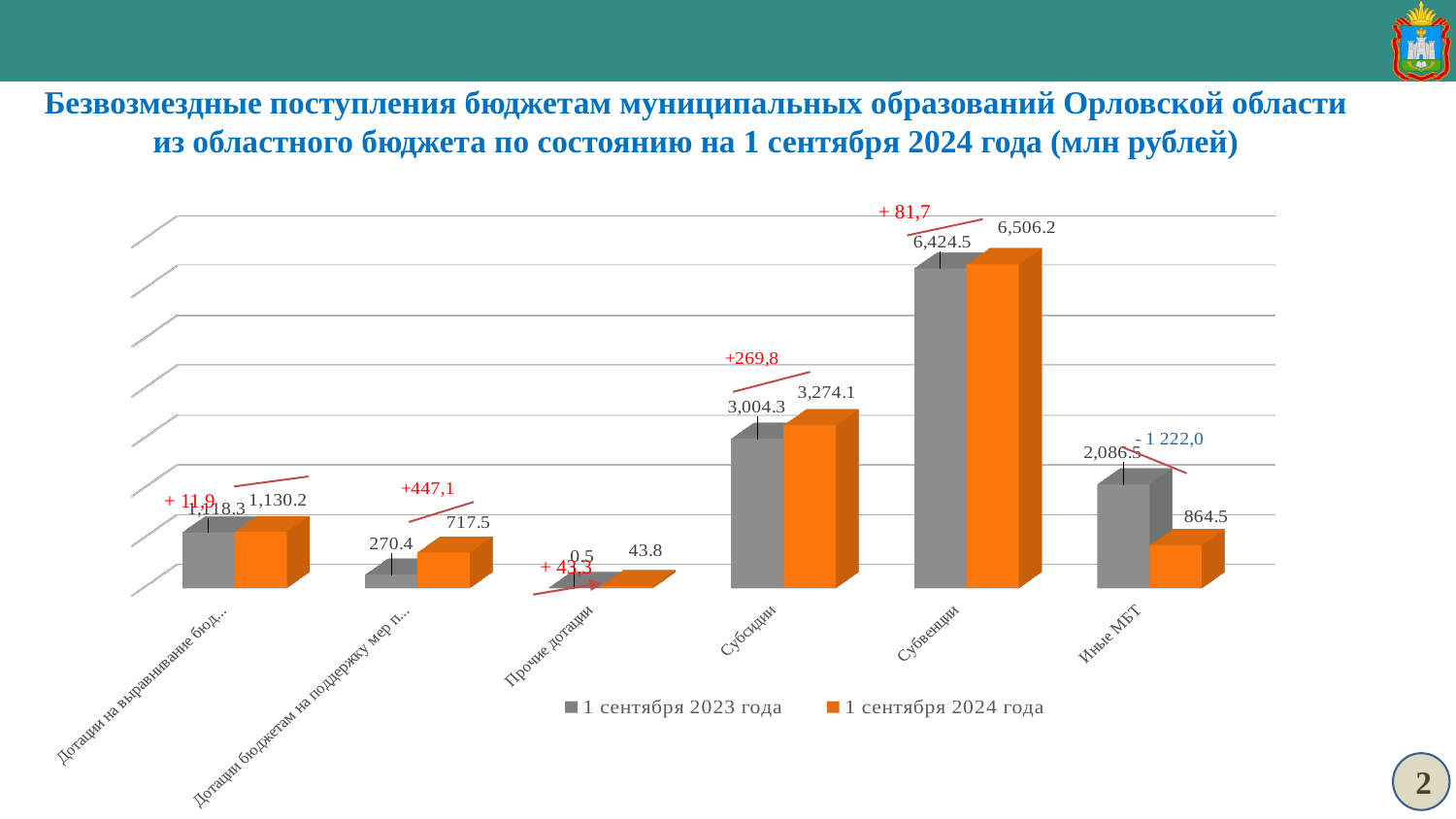
What is the value for Субсидии in the series 1 сентября 2023 года? 3,004.3 Which category has the highest value in the series 1 сентября 2024 года? Субвенции How many series does the legend list? 2 For Иные МБТ, which series has the larger value: 1 сентября 2023 года or 1 сентября 2024 года? 1 сентября 2023 года What is the value for Прочие дотации in the series 1 сентября 2023 года? 0.5 By how much did the value for Иные МБТ decrease from 1 сентября 2023 года to 1 сентября 2024 года? 1,222.0 What is the value for Субвенции in the series 1 сентября 2024 года? 6,506.2 How many categories are shown on the x axis? 6 Which category has the lowest value in the series 1 сентября 2023 года? Прочие дотации By how much did the value for Субвенции increase from 1 сентября 2023 года to 1 сентября 2024 года? 81.7 What kind of chart is shown on the slide? Bar chart What is the value for Иные МБТ in the series 1 сентября 2024 года? 864.5